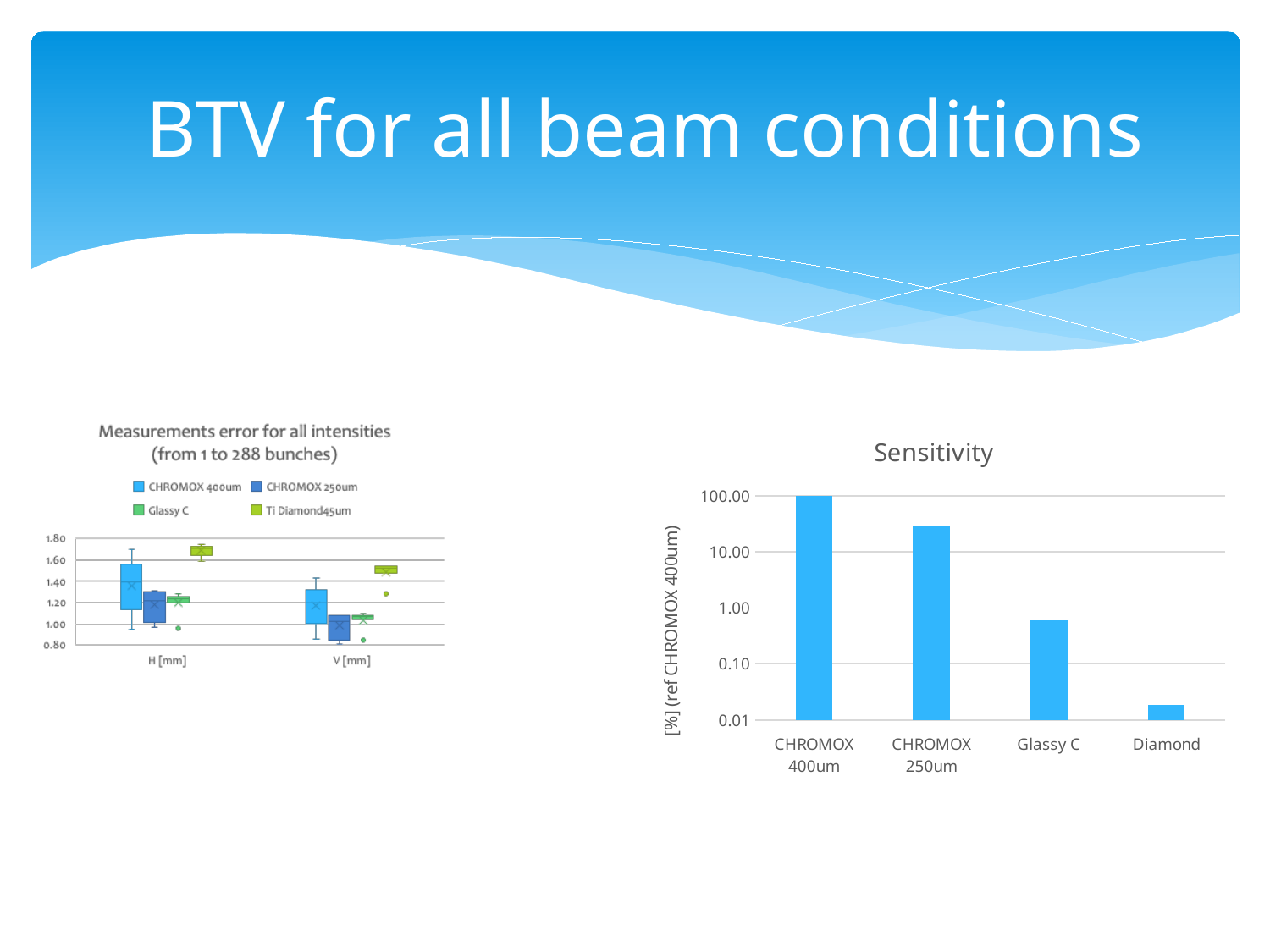
How many categories are shown on the Sensitivity chart? 4 On the Sensitivity chart, is the value for Diamond greater or less than 0.10? less On the Sensitivity chart, which is larger, the value for CHROMOX 250um or the value for Glassy C? CHROMOX 250um On the left chart (Measurements error for all intensities), is the value for Ti Diamond45um in H [mm] greater or less than 1.60? greater What kind of chart is the Sensitivity chart? Bar chart On the Sensitivity chart, is the value for CHROMOX 250um greater or less than 10.00? greater On the Sensitivity chart, what is the value for CHROMOX 400um? 100.00 On the Sensitivity chart, which category has the lowest value? Diamond On the Sensitivity chart, which category has the highest value? CHROMOX 400um On the Sensitivity chart, do the values rise or fall from left to right along the x axis? Fall How many series does the legend of the left chart (Measurements error for all intensities) list? 4